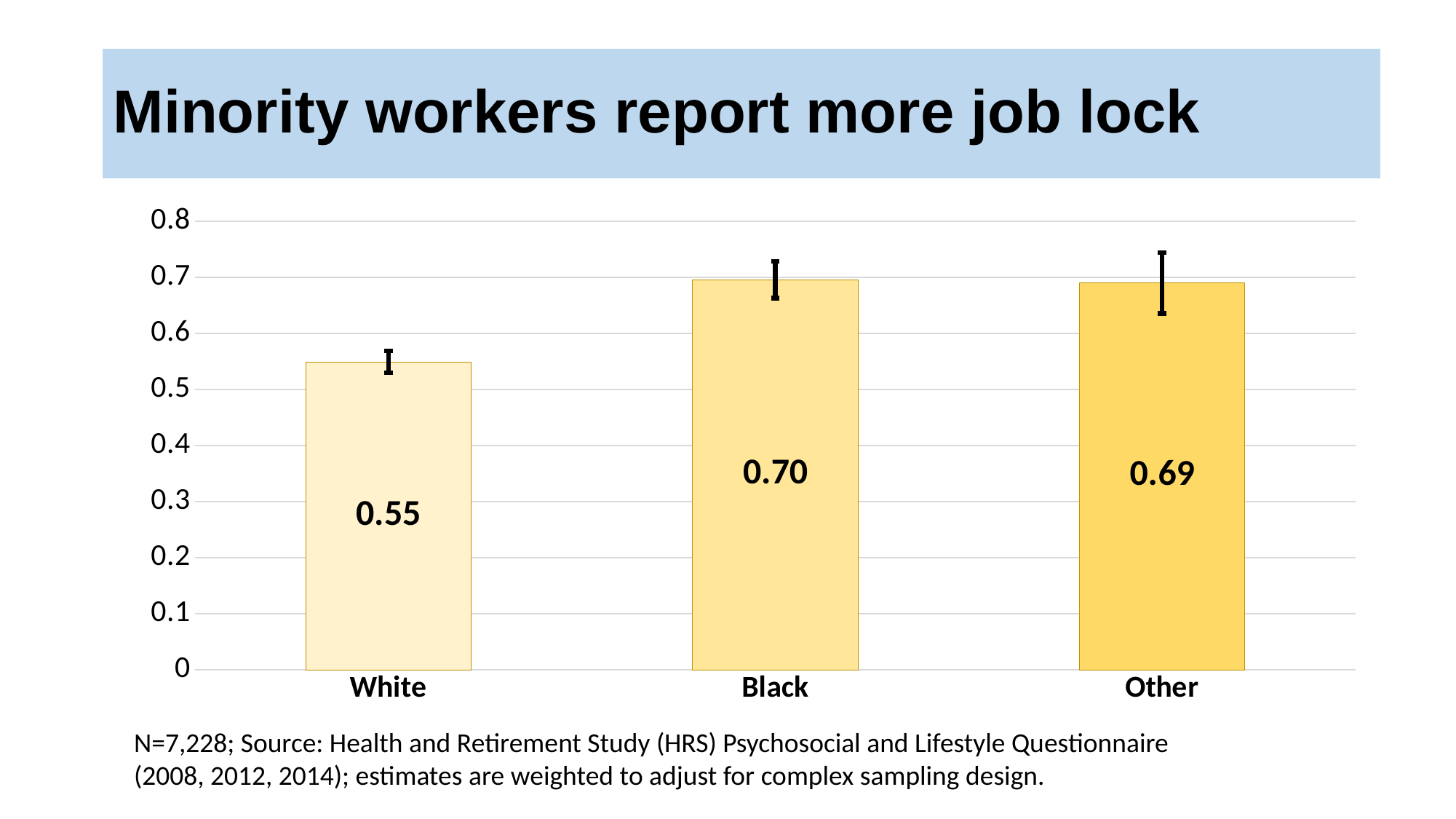
What is the value for Black? 0.70 Which category has the lowest value? White What is the title of the slide? Minority workers report more job lock What is the difference between the values for Other and White? 0.14 What is the value for Other? 0.69 How many categories are shown on the x axis? 3 What kind of chart is shown on the slide? bar chart Which category has the highest value? Black What is the value for White? 0.55 Which is larger, the value for White or the value for Other? Other What is the difference between the values for Black and White? 0.15 Is the value for White greater or less than 0.6? less